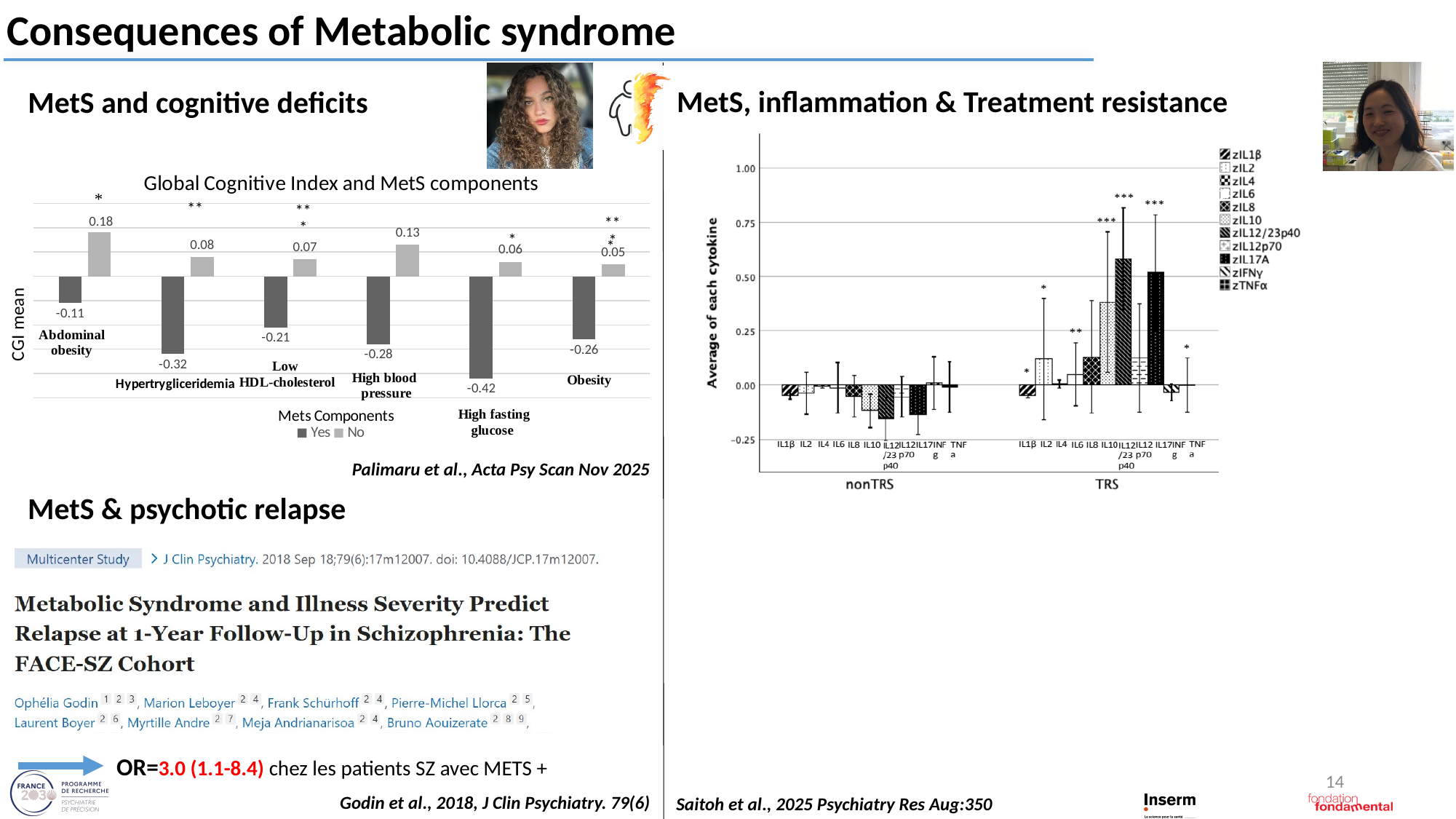
In the 'Global Cognitive Index and MetS components' chart, which MetS component has the lowest 'Yes' value? High fasting glucose What kind of chart is the 'Average of each cytokine' chart on the right of the slide? Bar chart How many series does the legend of the 'Global Cognitive Index and MetS components' chart list? 2 In the 'Global Cognitive Index and MetS components' chart, what is the CGI mean for the 'Yes' group for Hypertrygliceridemia? -0.32 In the 'Global Cognitive Index and MetS components' chart, what is the CGI mean for the 'No' group for Abdominal obesity? 0.18 In the 'Global Cognitive Index and MetS components' chart, which MetS component has the highest 'No' value? Abdominal obesity In the 'Average of each cytokine' chart, is the value for zIL17A in the TRS group greater or less than 0.25? greater In the 'Global Cognitive Index and MetS components' chart, what is the CGI mean for the 'Yes' group for High fasting glucose? -0.42 In the 'Global Cognitive Index and MetS components' chart, which is larger: the 'Yes' value for Obesity or the 'Yes' value for Low HDL-cholesterol? Low HDL-cholesterol In the 'Global Cognitive Index and MetS components' chart, what is the difference between the 'No' and 'Yes' values for High blood pressure? 0.41 How many MetS components are shown on the x axis of the 'Global Cognitive Index and MetS components' chart? 6 How many cytokine series does the legend of the 'Average of each cytokine' chart list? 11